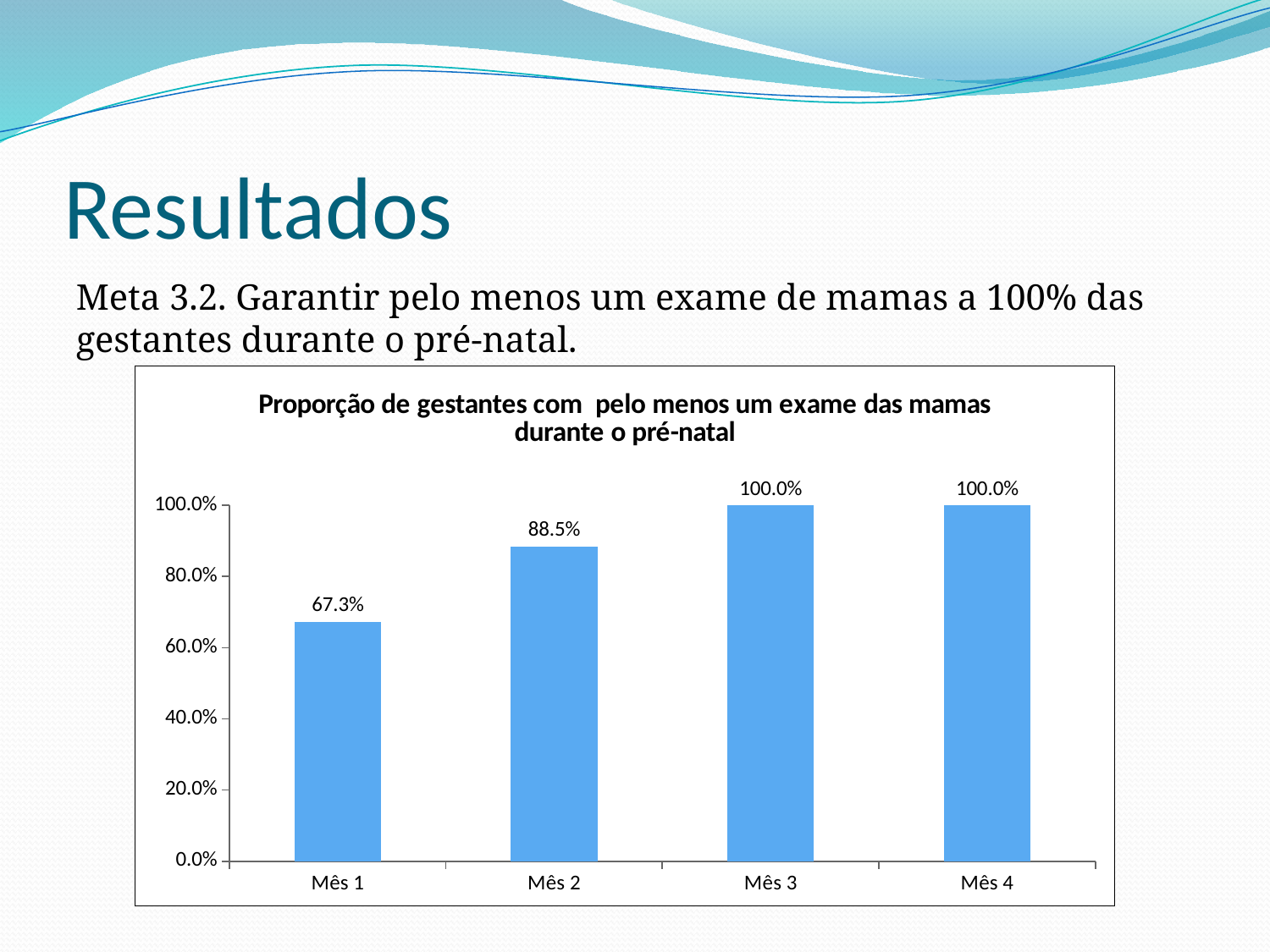
What kind of chart is shown on the slide? bar chart What is the value for Mês 3? 100.0% What is the value for Mês 2? 88.5% Is the value for Mês 1 greater or less than 80.0%? less Which month has the lowest value? Mês 1 What is the difference between the values for Mês 2 and Mês 1? 21.2% How many months are shown on the x axis? 4 What is the difference between the values for Mês 3 and Mês 2? 11.5% Do the values rise or fall from Mês 1 to Mês 3? rise Which is larger, the value for Mês 1 or the value for Mês 2? Mês 2 What is the title of the chart? Proporção de gestantes com pelo menos um exame das mamas durante o pré-natal What is the value for Mês 1? 67.3%